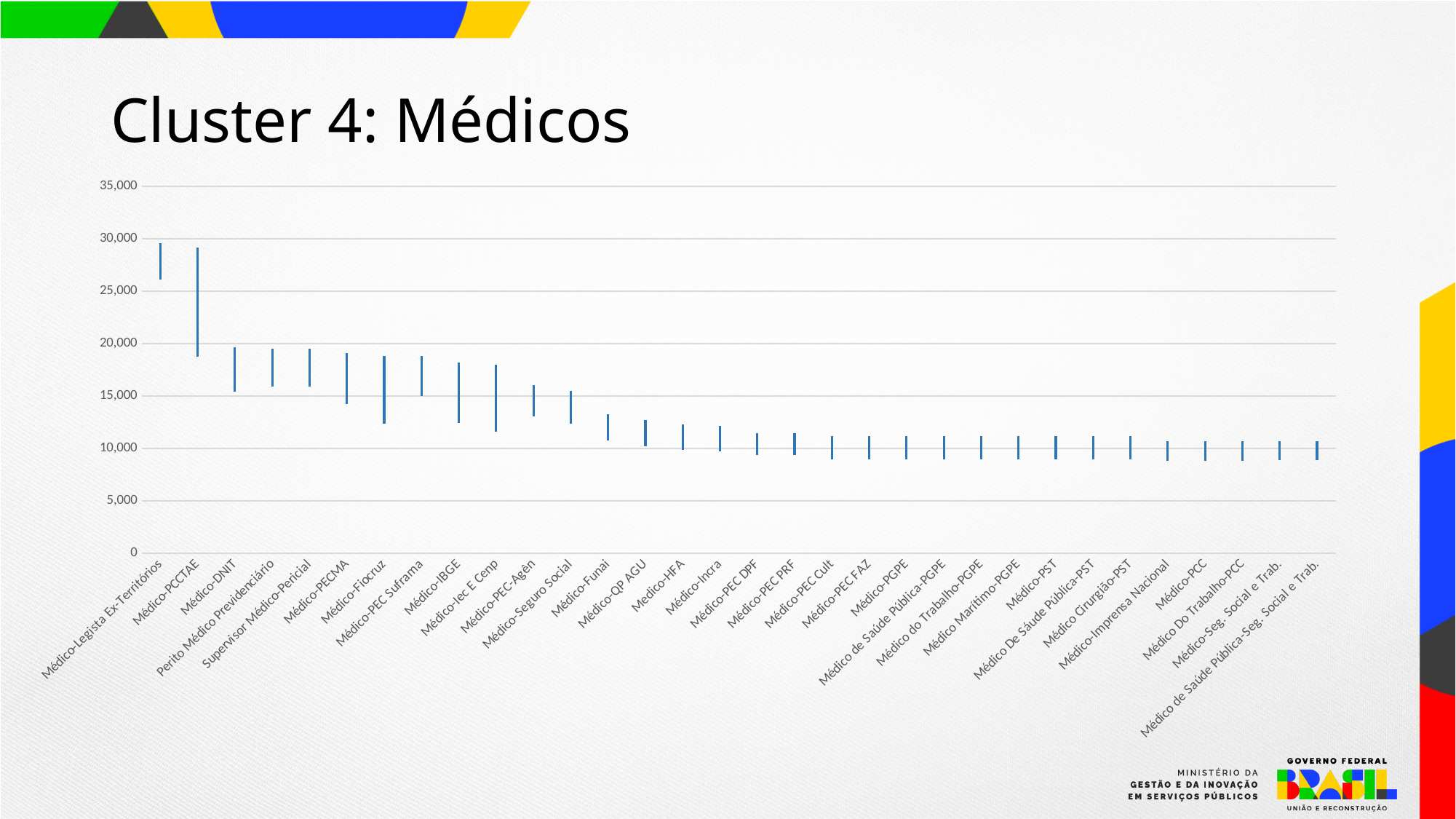
Do the values generally rise or fall moving from left to right along the x axis? fall Is the value range for Médico-DNIT greater or less than 20,000? less Is the value range for Médico-PCC greater or less than 15,000? less Is the value range for Médico-Legista Ex-Territórios greater or less than 25,000? greater What is the highest value shown on the chart's vertical axis? 35,000 Which has higher values, Médico-Legista Ex-Territórios or Médico-Funai? Médico-Legista Ex-Territórios What is the title of the slide containing the chart? Cluster 4: Médicos What is the label of the first category on the left of the x axis? Médico-Legista Ex-Territórios How many categories are shown along the x axis of the chart? 32 Which has higher values, Médico-DNIT or Médico-PCC? Médico-DNIT